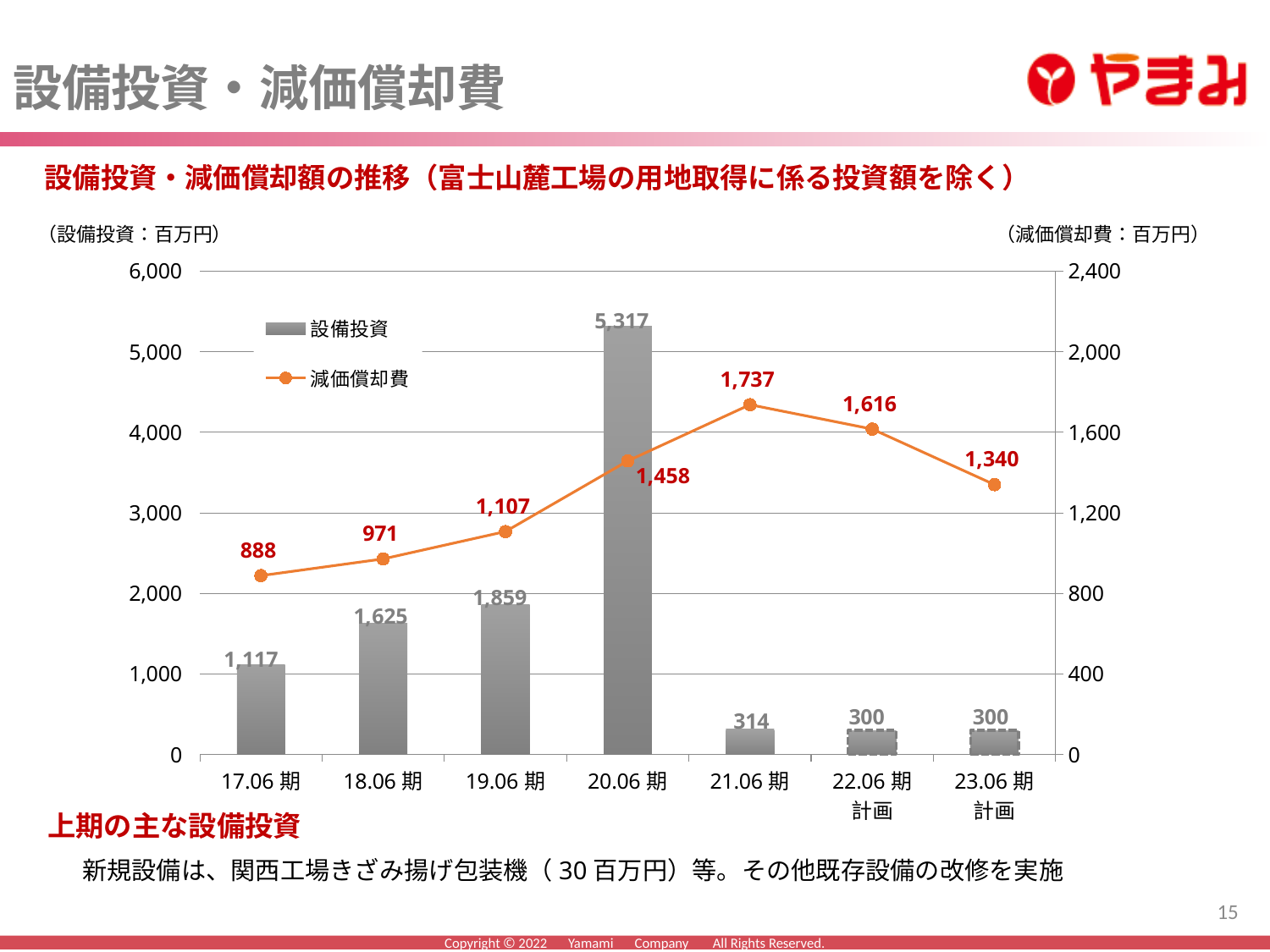
19.06期と18.06期の設備投資の差はいくらですか？ 234 20.06期の設備投資の値はいくらですか？ 5,317 21.06期の設備投資の値は1,000より大きいですか、小さいですか？ 小さい 21.06期の減価償却費の値はいくらですか？ 1,737 18.06期の設備投資と減価償却費では、どちらの値が大きいですか？ 設備投資 グラフには何期分のデータが表示されていますか？ 7 22.06期計画と23.06期計画の減価償却費の差はいくらですか？ 276 凡例にはいくつの系列が表示されていますか？ 2 減価償却費は17.06期から21.06期にかけて増加していますか、減少していますか？ 増加 減価償却費が最も低いのはどの期ですか？ 17.06期 設備投資はどのような形式で表示されていますか？ 棒グラフ 設備投資が最も高いのはどの期ですか？ 20.06期